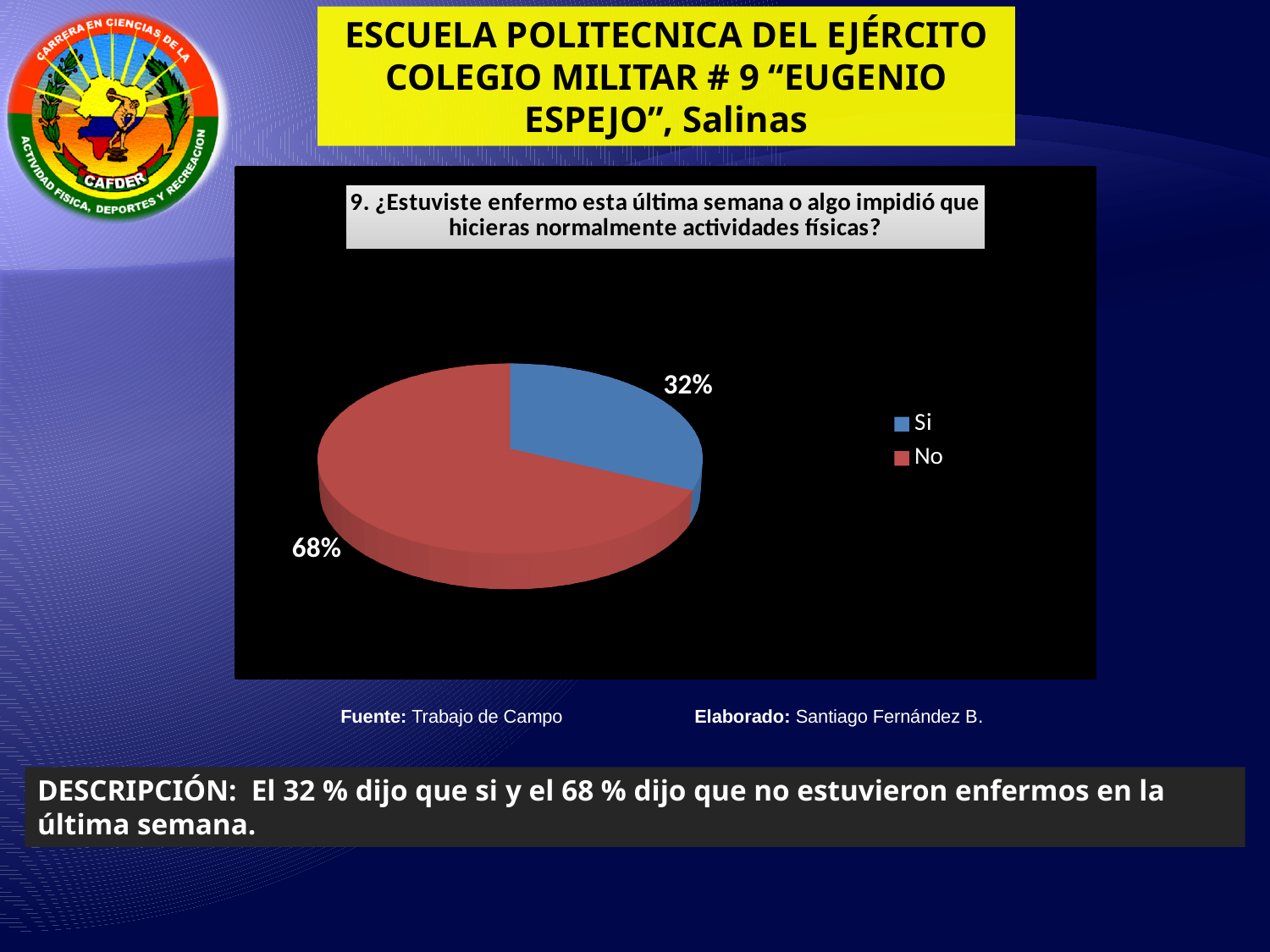
How many entries does the legend list? 2 What percentage of respondents answered "No"? 68% How many slices does the pie chart have? 2 Which category has the largest share of the pie? No Which is larger, the share for "Si" or the share for "No"? No What colour is the "Si" slice in the pie chart? Blue What is the title of the chart? 9. ¿Estuviste enfermo esta última semana o algo impidió que hicieras normalmente actividades físicas? Which category has the smallest share of the pie? Si What kind of chart is shown on the slide? Pie chart What percentage of respondents answered "Si"? 32% What share of the pie does the "No" slice represent? 68% What is the difference in percentage points between the "No" and "Si" slices? 36